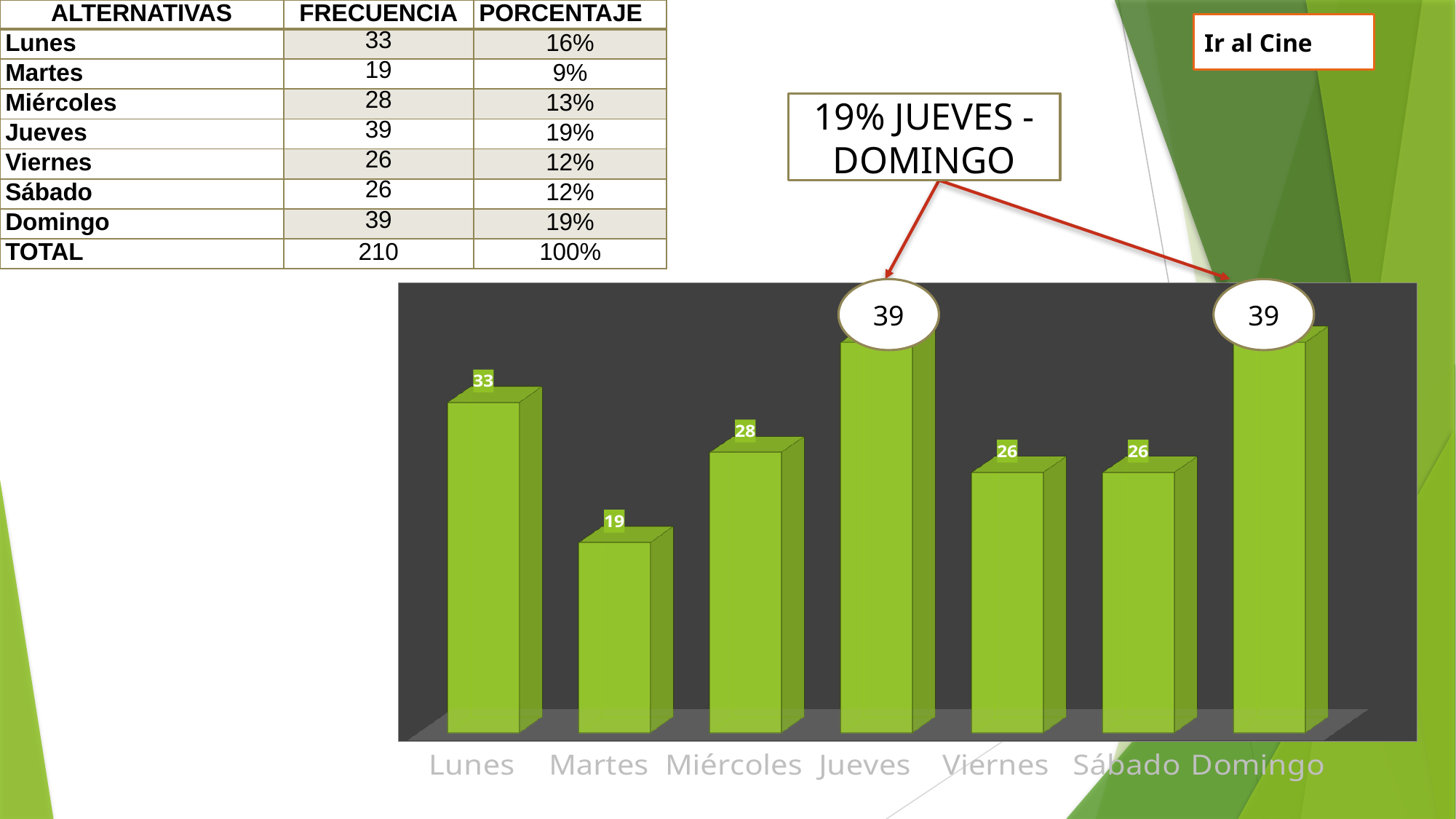
What kind of chart is shown on the slide? Bar chart What is the value for Domingo in the bar chart? 39 What is the title shown in the box at the top right of the slide? Ir al Cine What is the value for Lunes in the bar chart? 33 What is the value for Viernes in the bar chart? 26 How many categories are shown on the x axis of the bar chart? 7 What is the value for Miércoles in the bar chart? 28 What is the value for Martes in the bar chart? 19 Which category has the lowest value in the bar chart? Martes Which is larger, the value for Lunes or the value for Miércoles? Lunes What is the difference between the values for Jueves and Martes? 20 Which two categories share the highest value in the bar chart? Jueves and Domingo